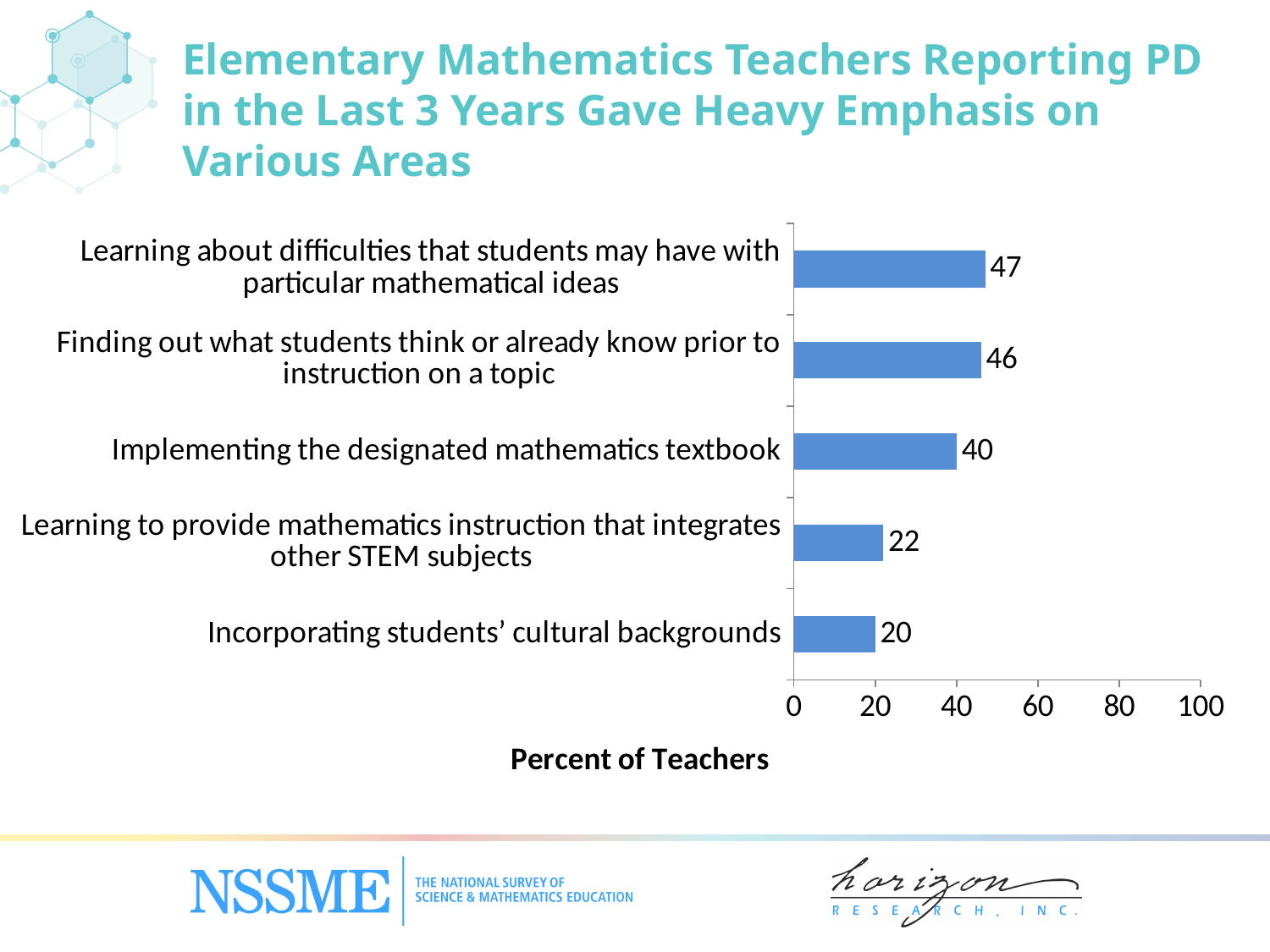
Which has a higher percent of teachers: implementing the designated mathematics textbook or learning to provide mathematics instruction that integrates other STEM subjects? Implementing the designated mathematics textbook Which area has the lowest percent of teachers reporting heavy emphasis? Incorporating students' cultural backgrounds Is the value for finding out what students think or already know prior to instruction on a topic greater or less than 40? greater What is the difference in percent of teachers between finding out what students think or already know prior to instruction on a topic and incorporating students' cultural backgrounds? 26 What is the label of the horizontal axis? Percent of Teachers What percent of teachers reported heavy emphasis on implementing the designated mathematics textbook? 40 How many areas are shown in the chart? 5 What percent of teachers reported heavy emphasis on learning about difficulties that students may have with particular mathematical ideas? 47 What percent of teachers reported heavy emphasis on learning to provide mathematics instruction that integrates other STEM subjects? 22 What kind of chart is shown on the slide? Bar chart What percent of teachers reported heavy emphasis on incorporating students' cultural backgrounds? 20 Which area has the highest percent of teachers reporting heavy emphasis? Learning about difficulties that students may have with particular mathematical ideas